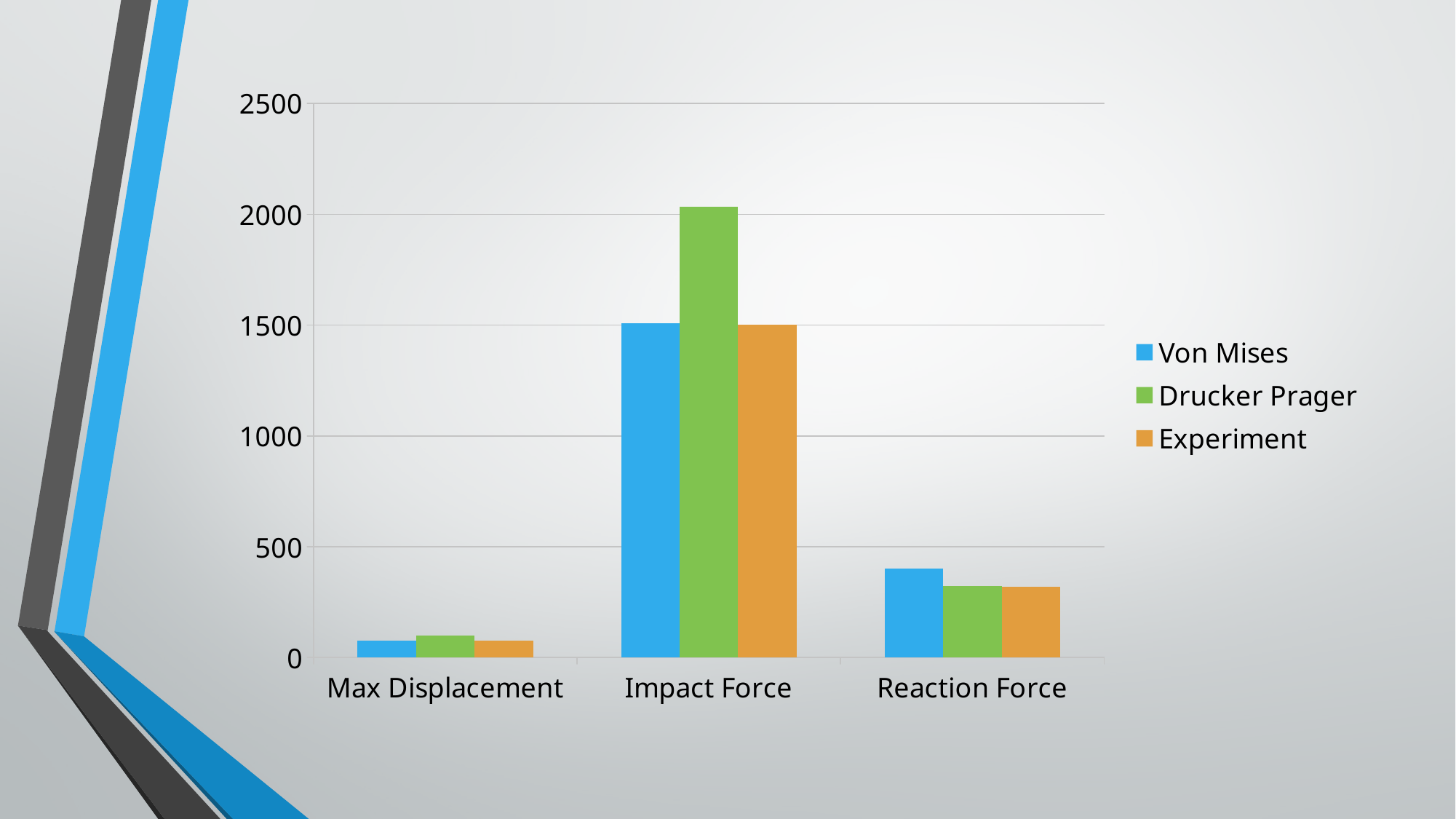
What kind of chart is shown on the slide? bar chart Is the Von Mises value for Reaction Force greater or less than 500? less Which category has the lowest values overall? Max Displacement Is the Experiment value for Impact Force greater or less than 1000? greater For Impact Force, which is larger: the Von Mises value or the Drucker Prager value? Drucker Prager Which series has the highest value for Impact Force? Drucker Prager How many categories are shown on the x axis? 3 Is the Drucker Prager value for Impact Force greater or less than 2000? greater Which series is shown in orange in the legend? Experiment For Reaction Force, which is larger: the Von Mises value or the Drucker Prager value? Von Mises How many series does the legend list? 3 Which series is shown in green in the legend? Drucker Prager